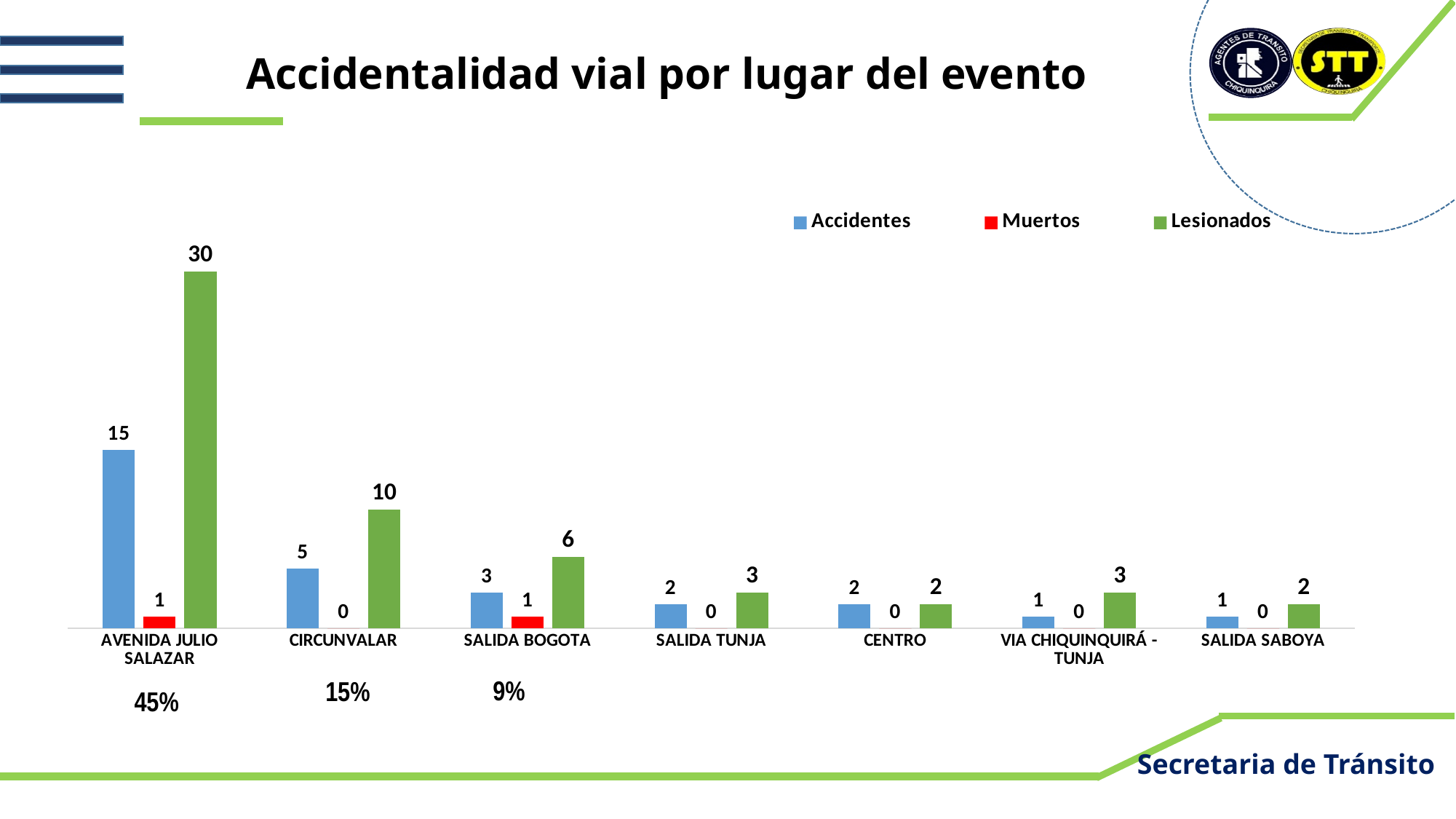
How many categories are shown on the x axis? 7 What is the value of Accidentes for CIRCUNVALAR? 5 What is the value of Lesionados for AVENIDA JULIO SALAZAR? 30 Which category has the highest value for Accidentes? AVENIDA JULIO SALAZAR How many series does the legend list? 3 What is the title of the chart? Accidentalidad vial por lugar del evento What is the value of Lesionados for VIA CHIQUINQUIRÁ - TUNJA? 3 What kind of chart is shown on the slide? Bar chart Which is larger: Accidentes for SALIDA BOGOTA or Accidentes for SALIDA TUNJA? SALIDA BOGOTA What is the difference between Lesionados for AVENIDA JULIO SALAZAR and CIRCUNVALAR? 20 What is the value of Muertos for SALIDA BOGOTA? 1 Which category has the lowest value for Lesionados? CENTRO and SALIDA SABOYA (both 2)